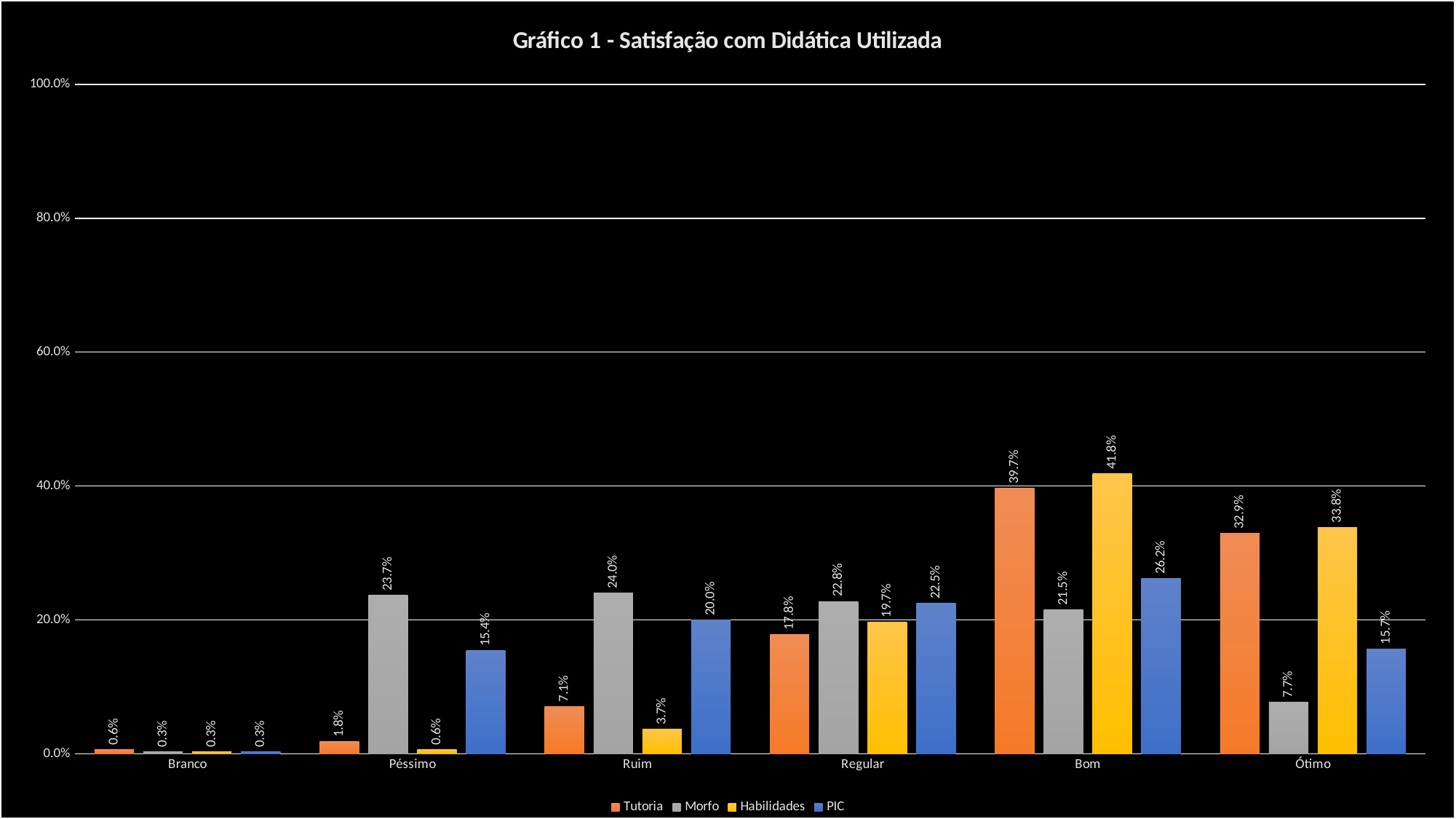
What is the difference between the Habilidades and Tutoria values in the Bom category? 2.1% How many series does the legend list? 4 In the Ótimo category, which is larger: Habilidades or PIC? Habilidades What is the value for PIC in the Ruim category? 20.0% In which category does the Tutoria series reach its highest value? Bom How many categories are shown on the x axis? 6 In which category does the Morfo series have its lowest value? Branco What type of chart is shown on the slide? Bar chart What is the value for Habilidades in the Bom category? 41.8% Is the value for Morfo in the Ruim category greater or less than 20.0%? greater What is the value for Morfo in the Péssimo category? 23.7% What is the value for Tutoria in the Ótimo category? 32.9%